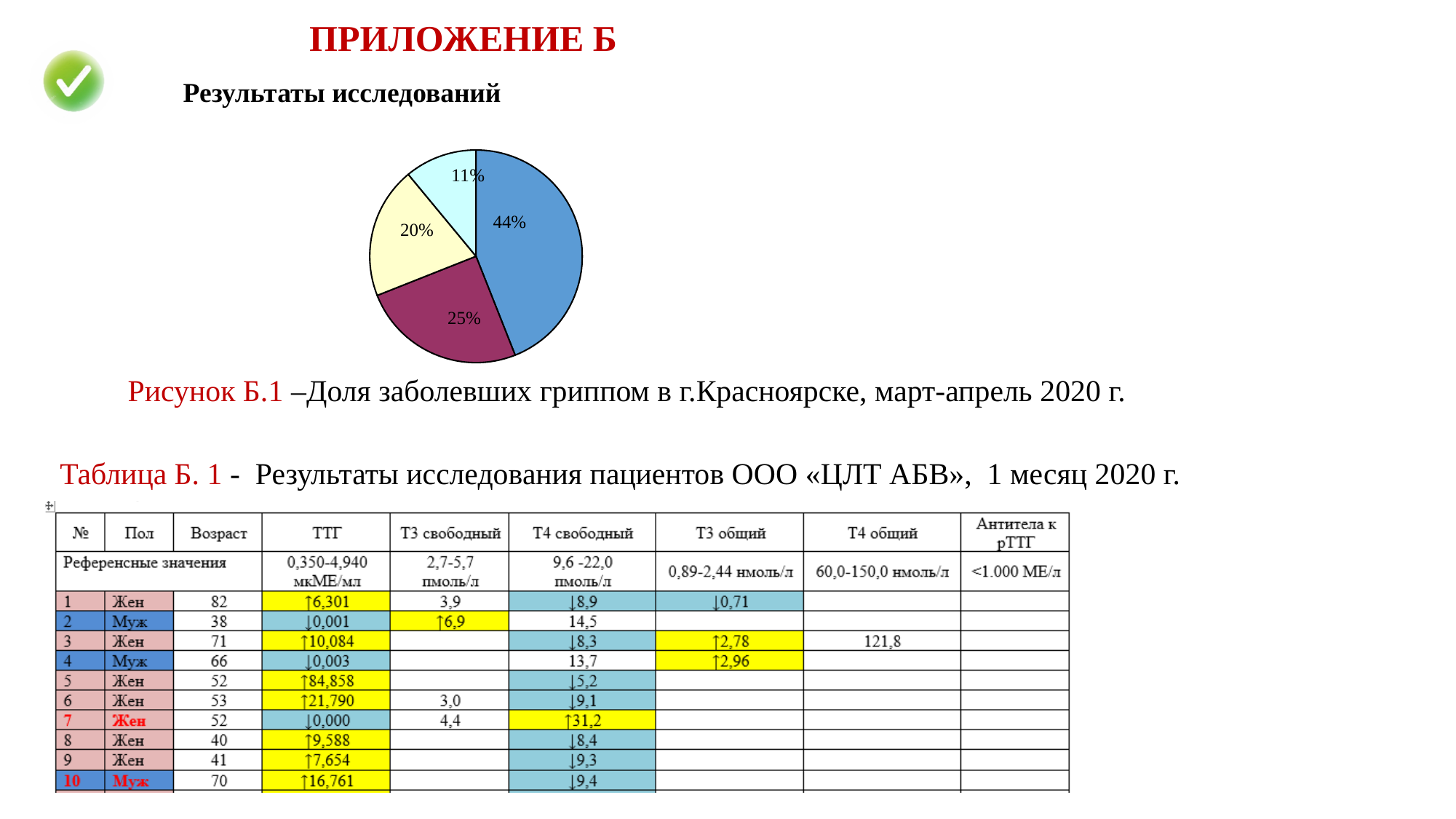
What is the smallest share shown in the pie chart? 11% What is the difference between the 25% slice and the 20% slice in the pie chart? 5 percentage points What share does the blue slice of the pie chart represent? 44% What is the caption of the pie chart (Рисунок Б.1)? Доля заболевших гриппом в г.Красноярске, март-апрель 2020 г. Which slice is larger in the pie chart: the dark magenta slice or the light yellow slice? the dark magenta slice What is the difference between the largest and smallest slices of the pie chart? 33 percentage points What kind of chart is shown on the slide? pie chart How many slices does the pie chart have? 4 What is the largest share shown in the pie chart? 44% What share does the dark magenta slice of the pie chart represent? 25% What share does the light yellow slice of the pie chart represent? 20%